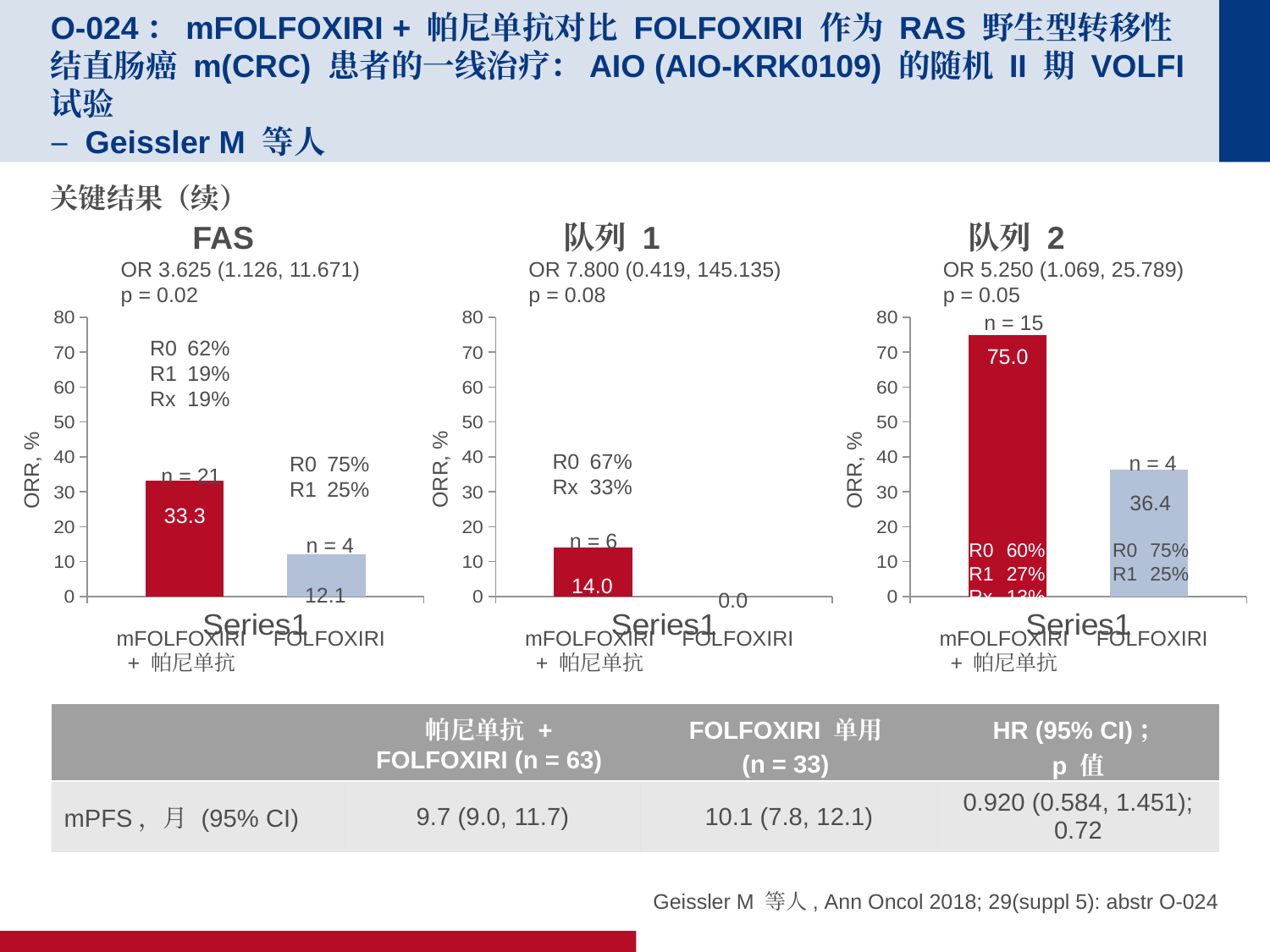
In the 队列 1 chart, what is the ORR value for mFOLFOXIRI + 帕尼单抗? 14.0 In the 队列 2 chart, what is the ORR value for FOLFOXIRI? 36.4 How many bars are plotted in the 队列 1 chart? 2 In the FAS chart, what is the ORR value for mFOLFOXIRI + 帕尼单抗? 33.3 In the FAS chart, what is the ORR value for FOLFOXIRI? 12.1 In the FAS chart, which arm has the higher ORR, mFOLFOXIRI + 帕尼单抗 or FOLFOXIRI? mFOLFOXIRI + 帕尼单抗 What kind of chart is the FAS chart? bar chart In the 队列 2 chart, what is the difference in ORR between mFOLFOXIRI + 帕尼单抗 and FOLFOXIRI? 38.6 In the 队列 2 chart, what is the ORR value for mFOLFOXIRI + 帕尼单抗? 75.0 In the 队列 1 chart, what is the ORR value for FOLFOXIRI? 0.0 What is the y-axis label on the 队列 2 chart? ORR, % In the 队列 2 chart, is the ORR for mFOLFOXIRI + 帕尼单抗 greater or less than 70? greater